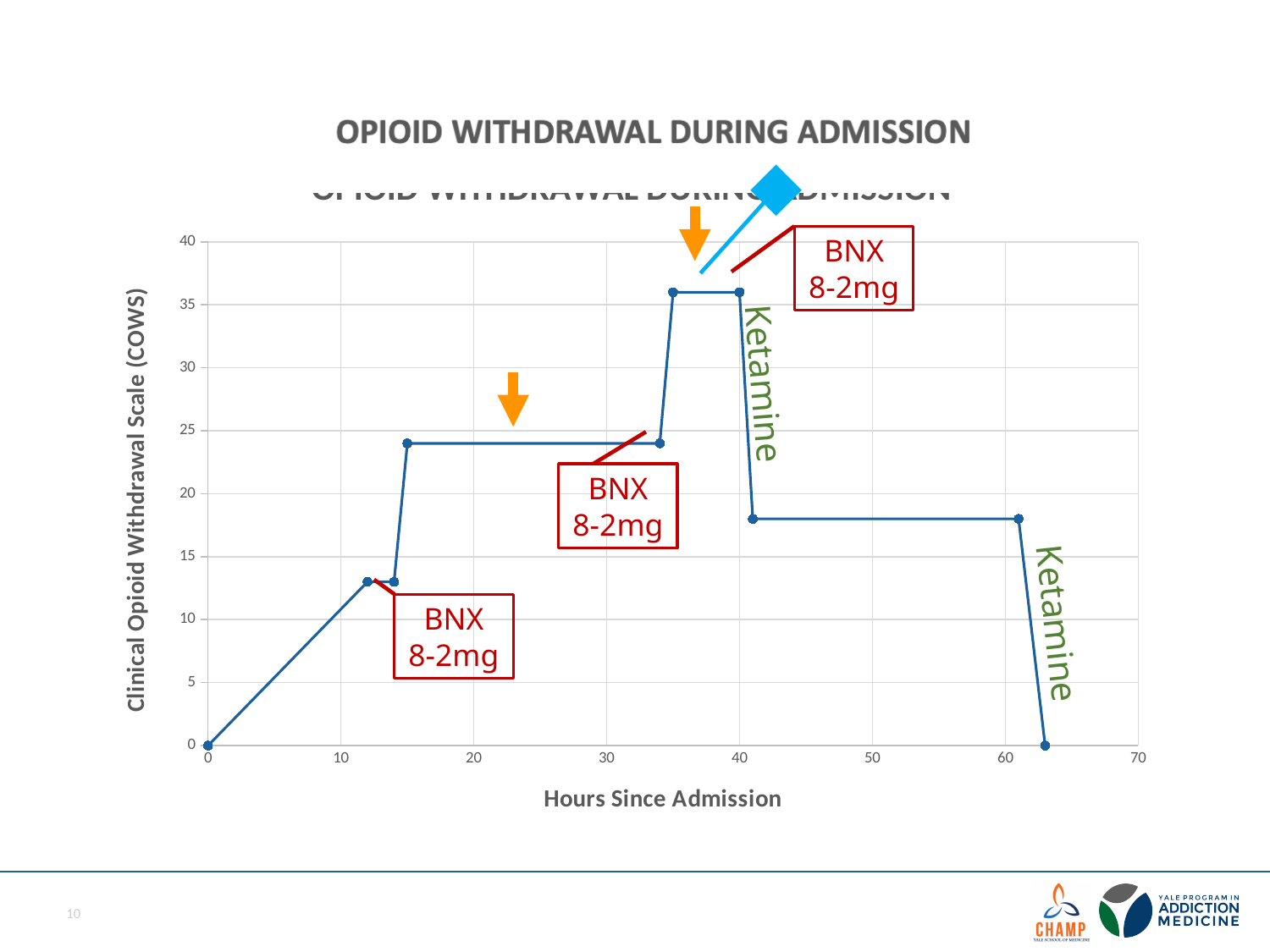
What kind of chart is shown on the slide? line chart What is the label of the y axis? Clinical Opioid Withdrawal Scale (COWS) What is the title of the chart? OPIOID WITHDRAWAL DURING ADMISSION What is the COWS value at 0 hours since admission? 0 Is the peak COWS value on the chart greater or less than 35? greater Does the COWS value rise or fall between 41 and 63 hours since admission? fall Is the COWS value at 50 hours since admission greater or less than 20? less Is the COWS value at 5 hours since admission greater or less than 10? less How many data points are marked on the line? 10 Does the COWS value rise or fall between 0 and 15 hours since admission? rise What is the COWS value at the final plotted point of the line? 0